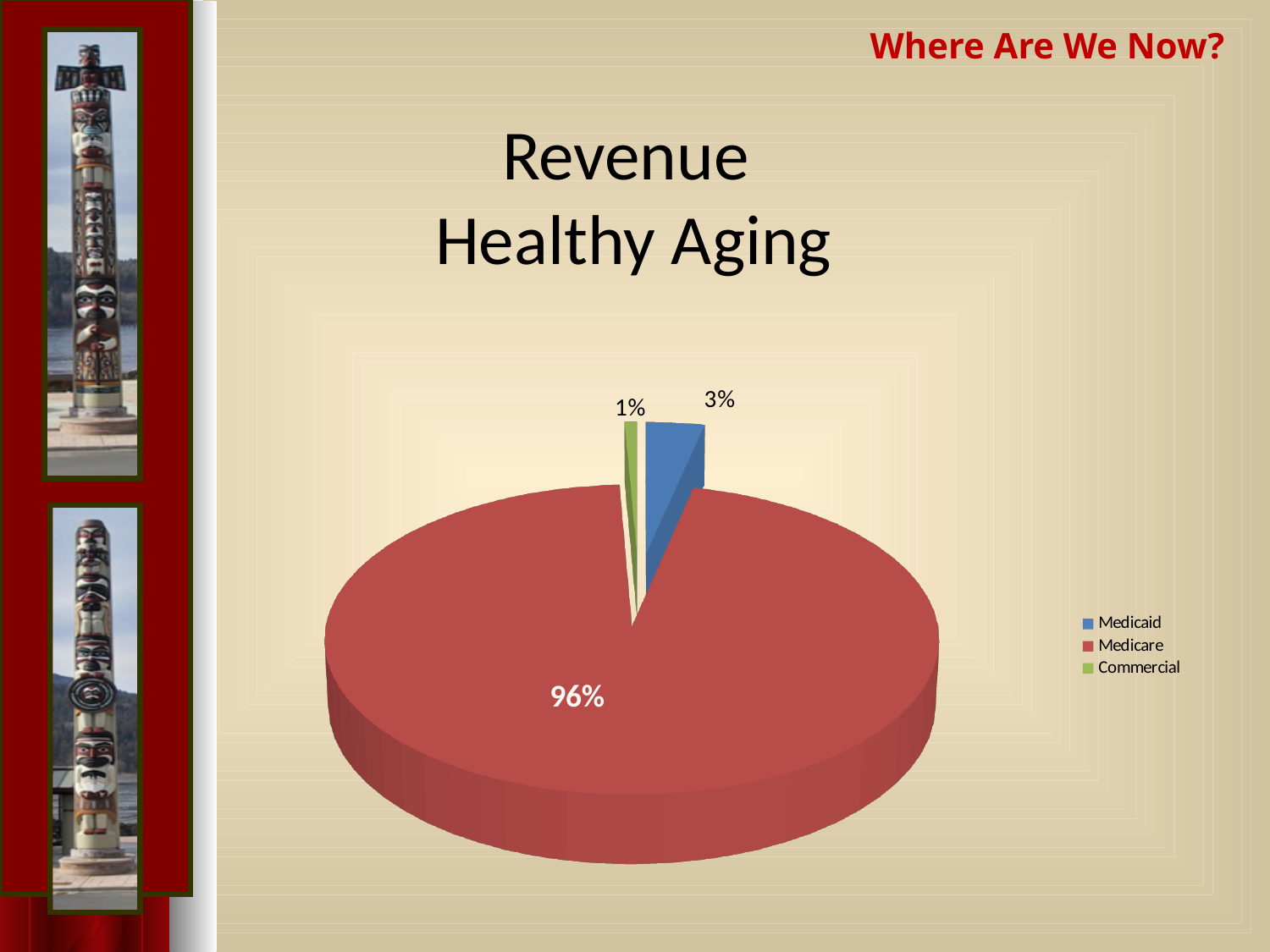
Which revenue source has the smallest share? Commercial What is the difference between the Medicare share and the Medicaid share? 93% Which is larger, the Medicaid share or the Commercial share? Medicaid What share of revenue does Medicare account for? 96% What kind of chart is shown on the slide? Pie chart How many entries does the legend list? 3 What share of revenue does Medicaid account for? 3% What is the difference between the Medicaid share and the Commercial share? 2% What share of revenue does Commercial account for? 1% What is the title of the chart? Revenue Healthy Aging How many slices does the pie chart have? 3 Which revenue source has the largest share? Medicare